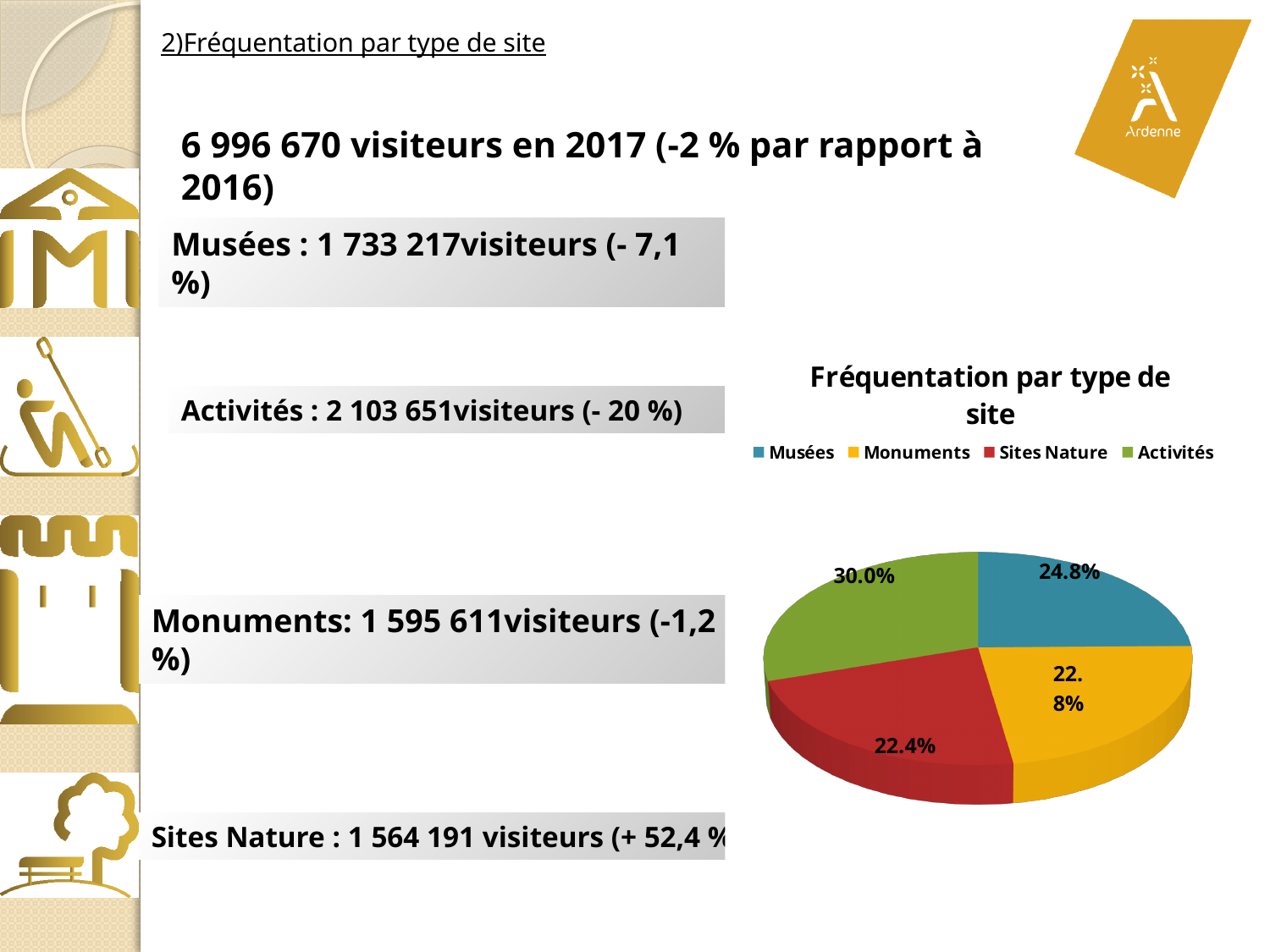
What share of the pie does Activités represent? 30.0% Which category has the smallest slice of the pie? Sites Nature How many slices does the pie chart have? 4 What share of the pie does Sites Nature represent? 22.4% What share of the pie does Monuments represent? 22.8% What is the difference in percentage points between the Activités slice and the Musées slice? 5.2 Which category has the largest slice of the pie? Activités What kind of chart is shown on the slide? pie chart Which colour represents Activités in the pie chart? green How many entries does the chart legend list? 4 What is the title of the chart? Fréquentation par type de site